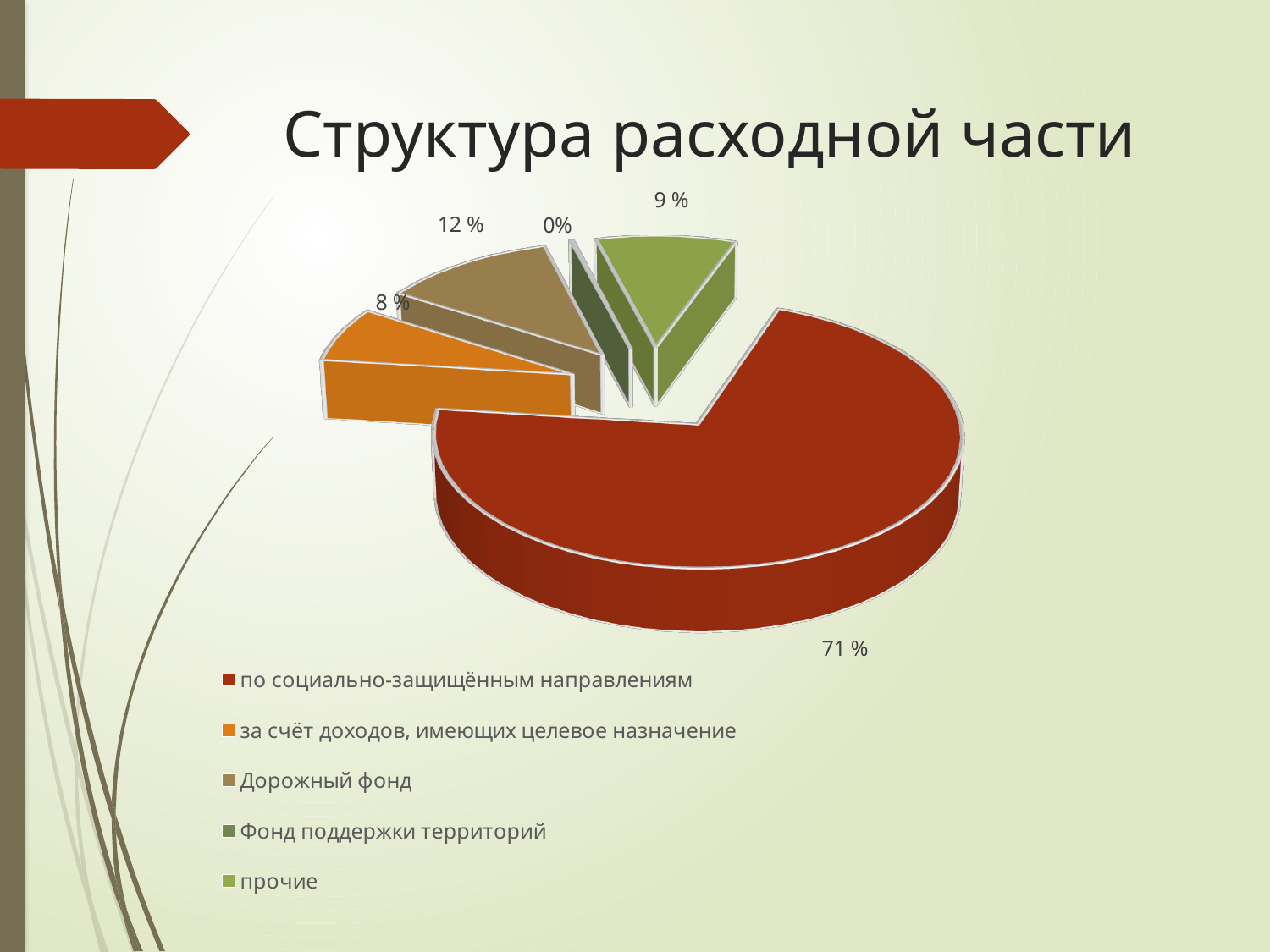
What kind of chart is shown on the slide? pie chart What share of the pie is labelled for "за счёт доходов, имеющих целевое назначение"? 8 % What share of the pie is labelled for "по социально-защищённым направлениям"? 71 % Which is larger: the share for "Дорожный фонд" or the share for "прочие"? Дорожный фонд What is the title of the chart? Структура расходной части Which category has the largest share of the pie? по социально-защищённым направлениям What is the difference in percentage points between the share for "по социально-защищённым направлениям" and the share for "Дорожный фонд"? 59 What share of the pie is labelled for "прочие"? 9 % What share of the pie is labelled for "Фонд поддержки территорий"? 0% What share of the pie is labelled for "Дорожный фонд"? 12 % Which category has the smallest share of the pie? Фонд поддержки территорий How many categories does the legend list? 5